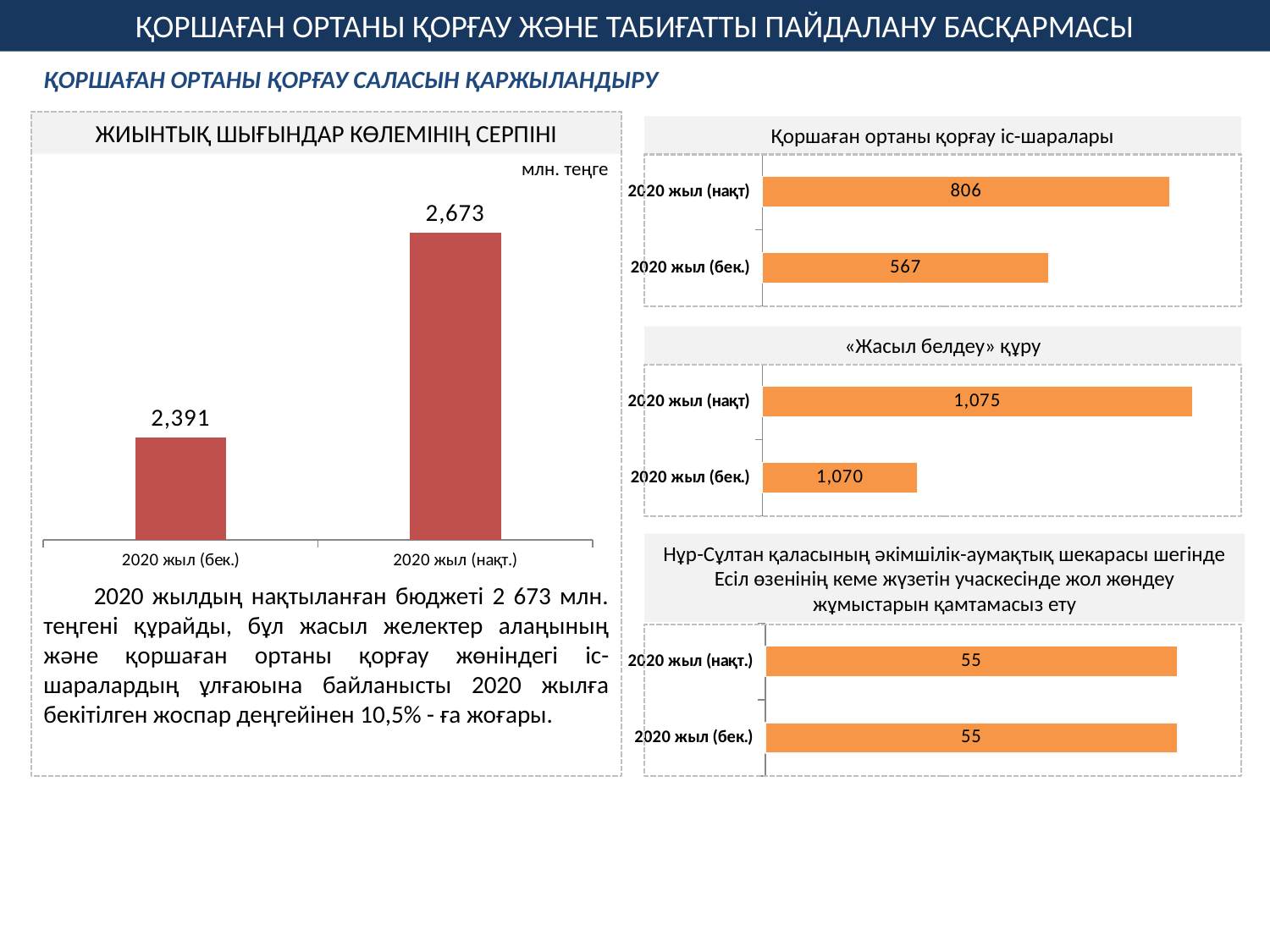
In the chart titled "Қоршаған ортаны қорғау іс-шаралары", which category has the higher value? 2020 жыл (нақт) What kind of chart is the one titled "ЖИЫНТЫҚ ШЫҒЫНДАР КӨЛЕМІНІҢ СЕРПІНІ"? Bar chart In the chart titled "ЖИЫНТЫҚ ШЫҒЫНДАР КӨЛЕМІНІҢ СЕРПІНІ", what is the value for 2020 жыл (нақт.)? 2,673 In the chart titled "Қоршаған ортаны қорғау іс-шаралары", what is the value for 2020 жыл (нақт)? 806 In the bottom-right chart about road repair works on the Есіл river, what is the value for 2020 жыл (бек.)? 55 In the chart titled "ЖИЫНТЫҚ ШЫҒЫНДАР КӨЛЕМІНІҢ СЕРПІНІ", what is the difference between the 2020 жыл (нақт.) and 2020 жыл (бек.) values? 282 In the chart titled "ЖИЫНТЫҚ ШЫҒЫНДАР КӨЛЕМІНІҢ СЕРПІНІ", what unit is shown for the values? млн. теңге In the chart titled "ЖИЫНТЫҚ ШЫҒЫНДАР КӨЛЕМІНІҢ СЕРПІНІ", what is the value for 2020 жыл (бек.)? 2,391 In the chart titled "«Жасыл белдеу» құру", what is the value for 2020 жыл (бек.)? 1,070 In the chart titled "Қоршаған ортаны қорғау іс-шаралары", what is the value for 2020 жыл (бек.)? 567 In the chart titled "Қоршаған ортаны қорғау іс-шаралары", what is the difference between the 2020 жыл (нақт) and 2020 жыл (бек.) values? 239 In the chart titled "«Жасыл белдеу» құру", what is the value for 2020 жыл (нақт)? 1,075